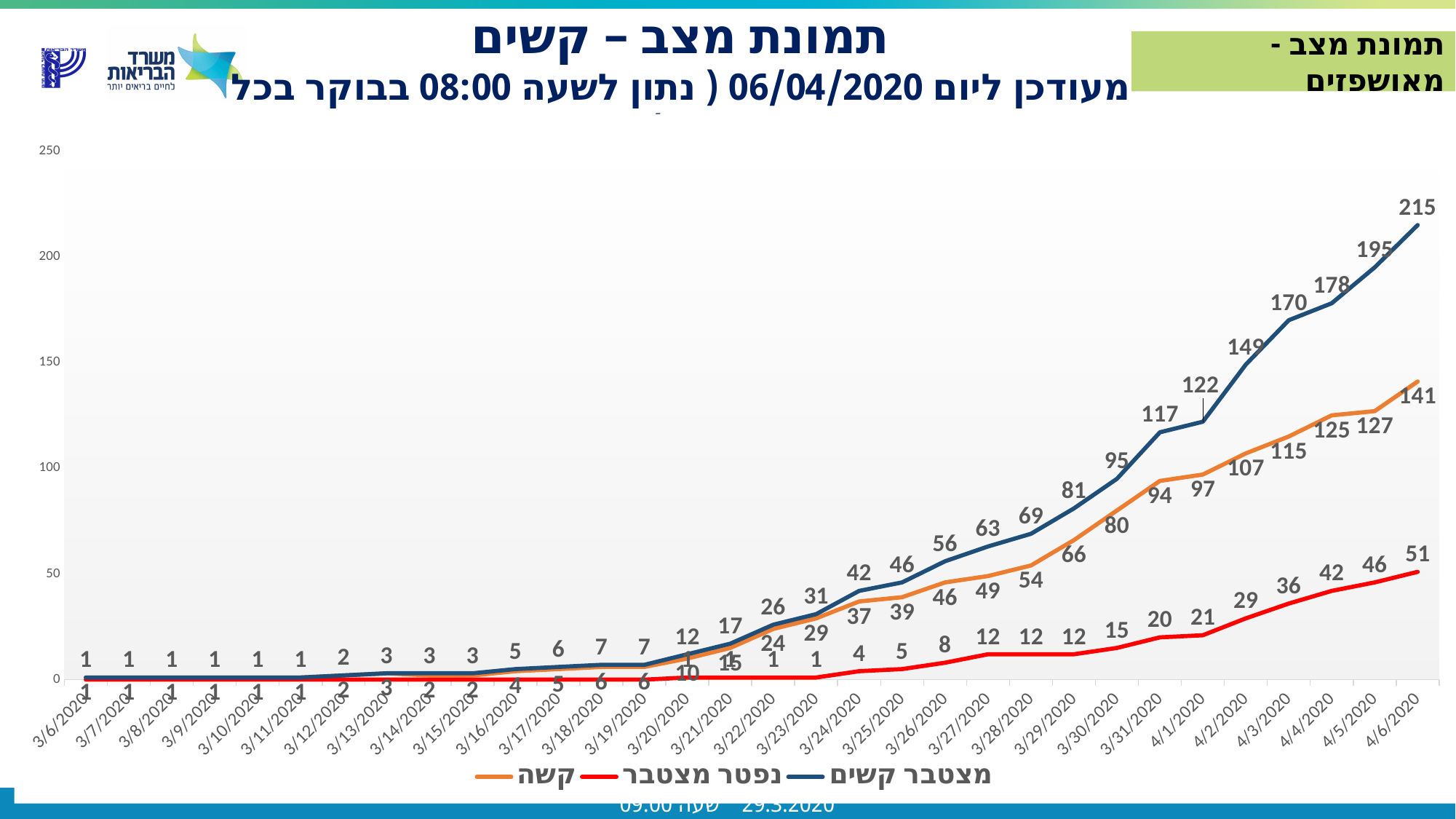
What is the value of the קשה series on 4/6/2020? 141 Does the מצטבר קשים series rise or fall from 3/6/2020 to 4/6/2020? rise What is the value of the מצטבר קשים series on 4/6/2020? 215 What is the value of the נפטר מצטבר series on 4/6/2020? 51 Which is larger on 4/4/2020: the מצטבר קשים value or the קשה value? מצטבר קשים On which date does the מצטבר קשים series reach its highest value? 4/6/2020 What is the difference between the מצטבר קשים value on 4/6/2020 and on 4/5/2020? 20 What type of chart is shown on the slide? line chart What colour is the line for the נפטר מצטבר series? red What is the value of the מצטבר קשים series on 3/31/2020? 117 What is the value of the נפטר מצטבר series on 4/3/2020? 36 How many series does the legend list? 3